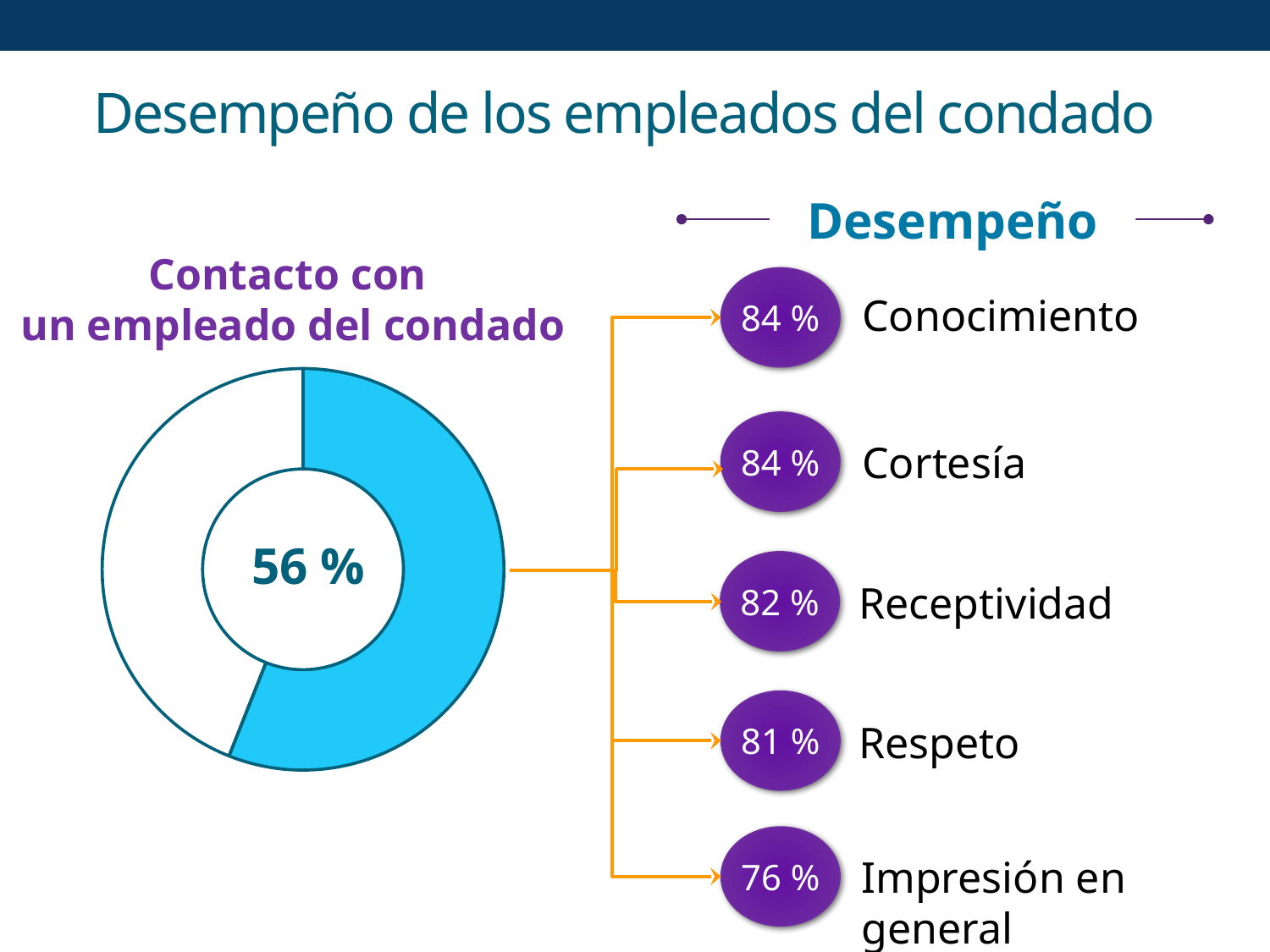
In the 'Desempeño' section, what percentage is shown for Respeto? 81 % What value is shown in the center of the donut chart titled 'Contacto con un empleado del condado'? 56 % In the 'Desempeño' section, what percentage is shown for Impresión en general? 76 % How many items are listed in the 'Desempeño' section? 5 What kind of chart is used to show 'Contacto con un empleado del condado'? Donut (pie) chart In the donut chart, is the blue slice greater or less than 50%? greater In the 'Desempeño' section, what percentage is shown for Receptividad? 82 % In the 'Desempeño' section, what is the difference between the percentage for Conocimiento and the percentage for Impresión en general? 8 percentage points In the 'Desempeño' section, which item has the lowest percentage? Impresión en general In the 'Desempeño' section, which is larger: the percentage for Receptividad or for Respeto? Receptividad What is the title of the donut chart on the left of the slide? Contacto con un empleado del condado In the 'Desempeño' section, what percentage is shown for Conocimiento? 84 %